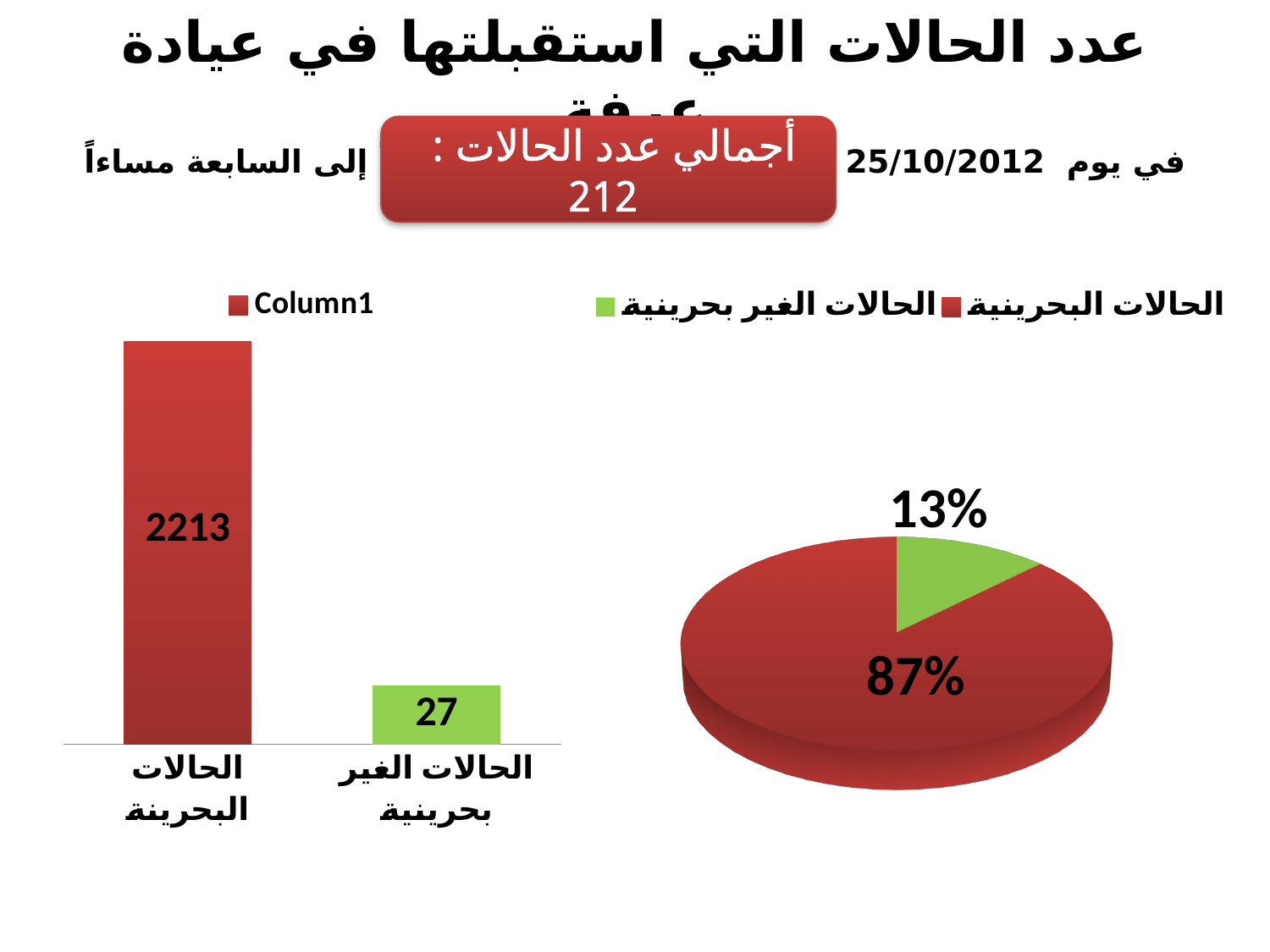
What kind of chart is the chart on the right of the slide? Pie chart In the pie chart on the right, what share does الحالات البحرينية have? 87% What kind of chart is the chart on the left of the slide? Bar chart In the pie chart on the right, what share does الحالات الغير بحرينية have? 13% In the bar chart on the left, which is larger: الحالات البحرينية or الحالات الغير بحرينية? الحالات البحرينية In the bar chart on the left, which category has the lowest value? الحالات الغير بحرينية In the bar chart on the left, which category has the highest value? الحالات البحرينية How many categories are shown in the bar chart on the left? 2 What is the legend entry of the bar chart on the left? Column1 In the bar chart on the left, what is the value for الحالات الغير بحرينية? 27 How many series does the legend of the bar chart on the left list? 1 In the pie chart on the right, what colour is the slice for الحالات الغير بحرينية? Green